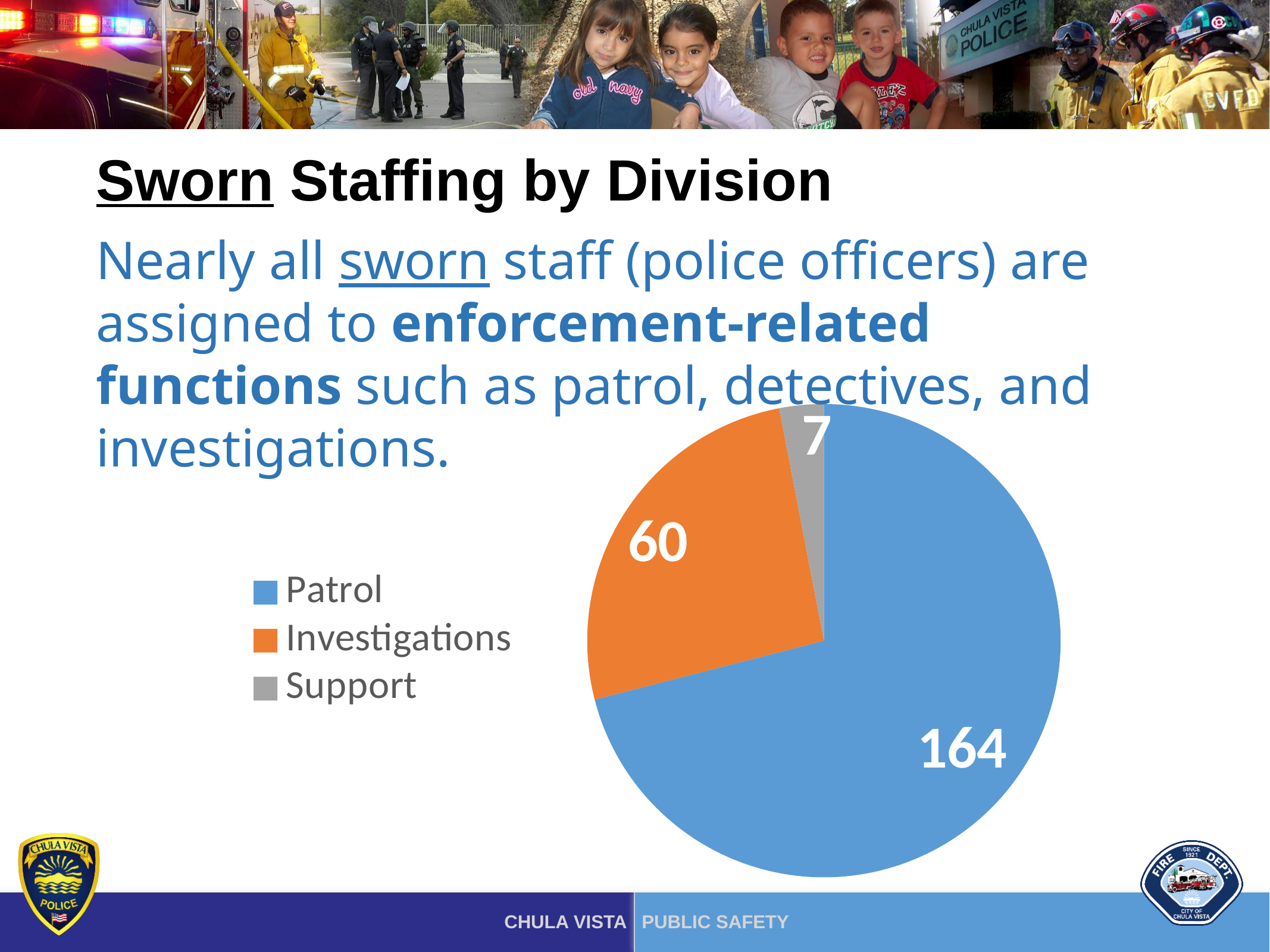
Which is larger in the pie chart, Investigations or Support? Investigations Which division has the largest slice of the pie chart? Patrol What is the total of all slices in the pie chart? 231 What type of chart is shown on the slide? pie chart Which division has the smallest slice of the pie chart? Support What is the value for Patrol in the pie chart? 164 What is the value for Support in the pie chart? 7 Which colour represents Investigations in the pie chart? orange What is the value for Investigations in the pie chart? 60 What is the difference between the Patrol and Investigations values in the pie chart? 104 What is the difference between the Investigations and Support values in the pie chart? 53 How many divisions are shown in the pie chart? 3